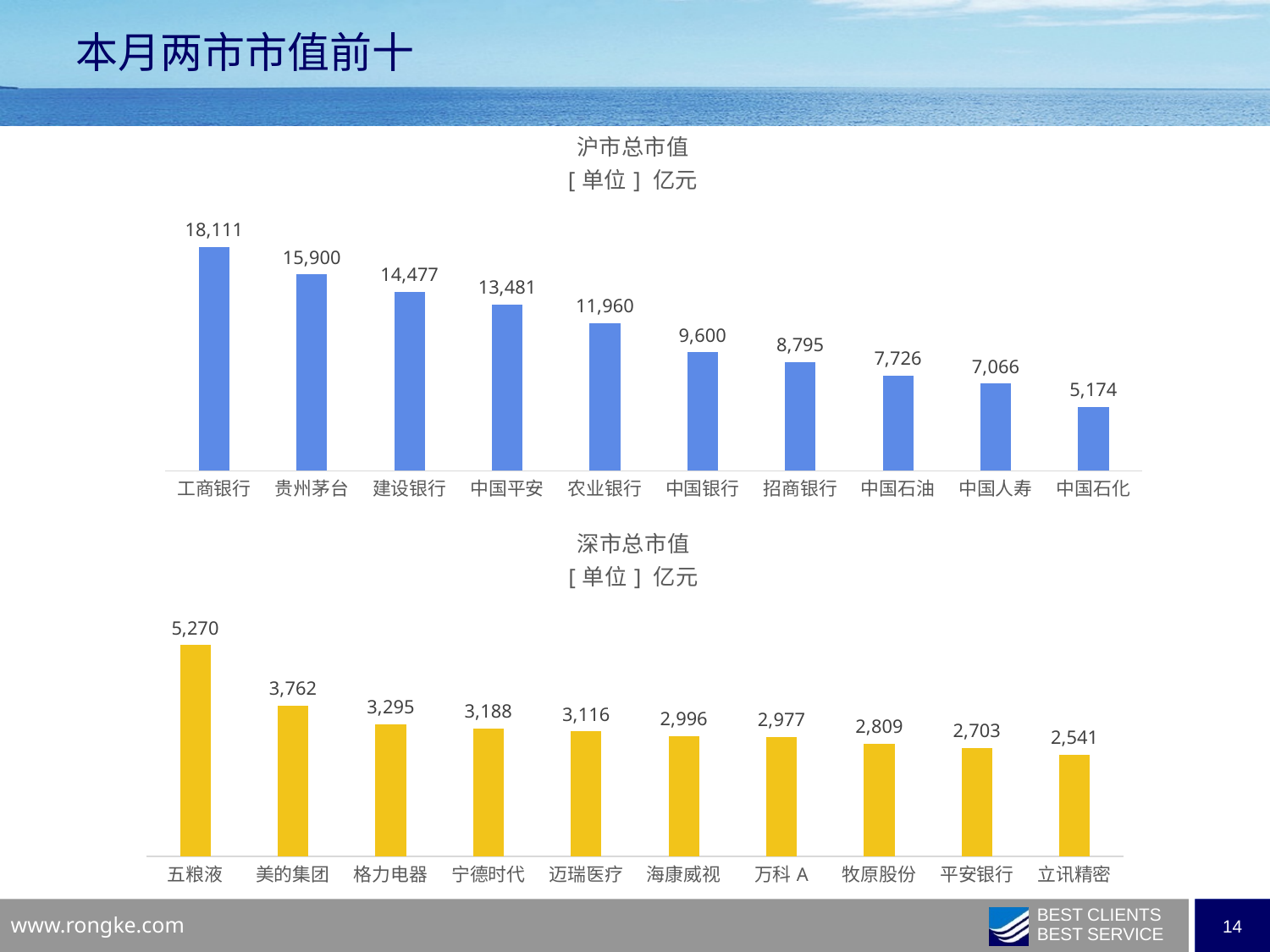
In the 沪市总市值 chart, what is the value for 贵州茅台? 15,900 In the 沪市总市值 chart, do the values rise or fall from left to right? fall In the 深市总市值 chart, what is the value for 宁德时代? 3,188 In the 沪市总市值 chart, which category has the highest value? 工商银行 What unit is stated under the title of the 沪市总市值 chart? 亿元 In the 沪市总市值 chart, which category has the lowest value? 中国石化 In the 深市总市值 chart, which is larger, the value for 美的集团 or the value for 格力电器? 美的集团 In the 沪市总市值 chart, what is the difference between the values for 工商银行 and 贵州茅台? 2,211 In the 深市总市值 chart, what is the difference between the values for 五粮液 and 立讯精密? 2,729 In the 深市总市值 chart, which category has the highest value? 五粮液 In the 沪市总市值 chart, how many categories are plotted? 10 What kind of chart is the 深市总市值 chart? bar chart